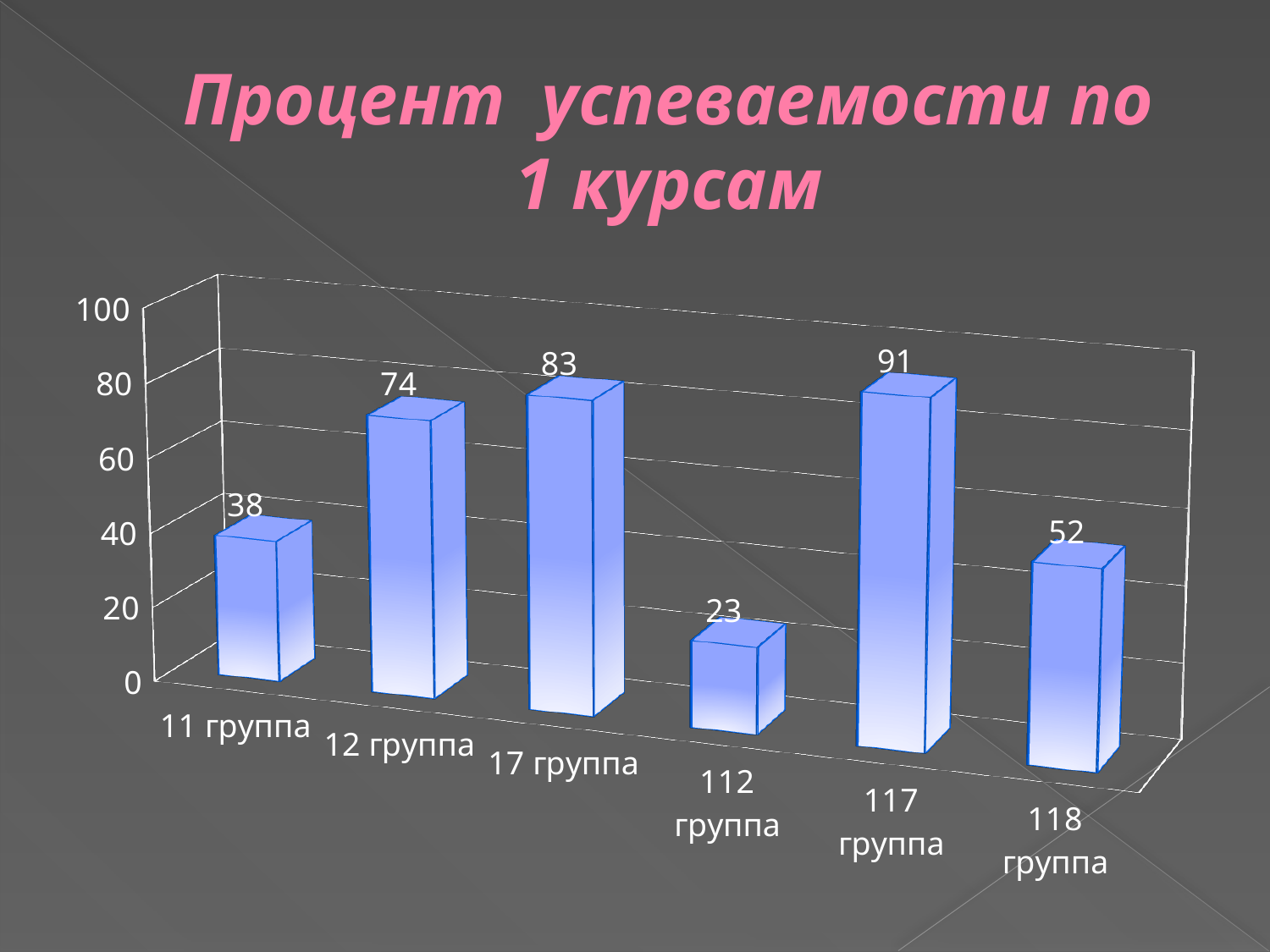
How many groups are shown on the chart? 6 What is the title of the chart? Процент успеваемости по 1 курсам Which group has the highest value? 117 группа Which is larger, the value for 118 группа or the value for 11 группа? 118 группа What is the difference between the values for 117 группа and 112 группа? 68 What is the value for 112 группа? 23 Which group has the lowest value? 112 группа What kind of chart is shown on the slide? bar chart What is the difference between the values for 17 группа and 12 группа? 9 What is the value for 117 группа? 91 What is the value for 11 группа? 38 Is the value for 12 группа greater or less than 60? greater